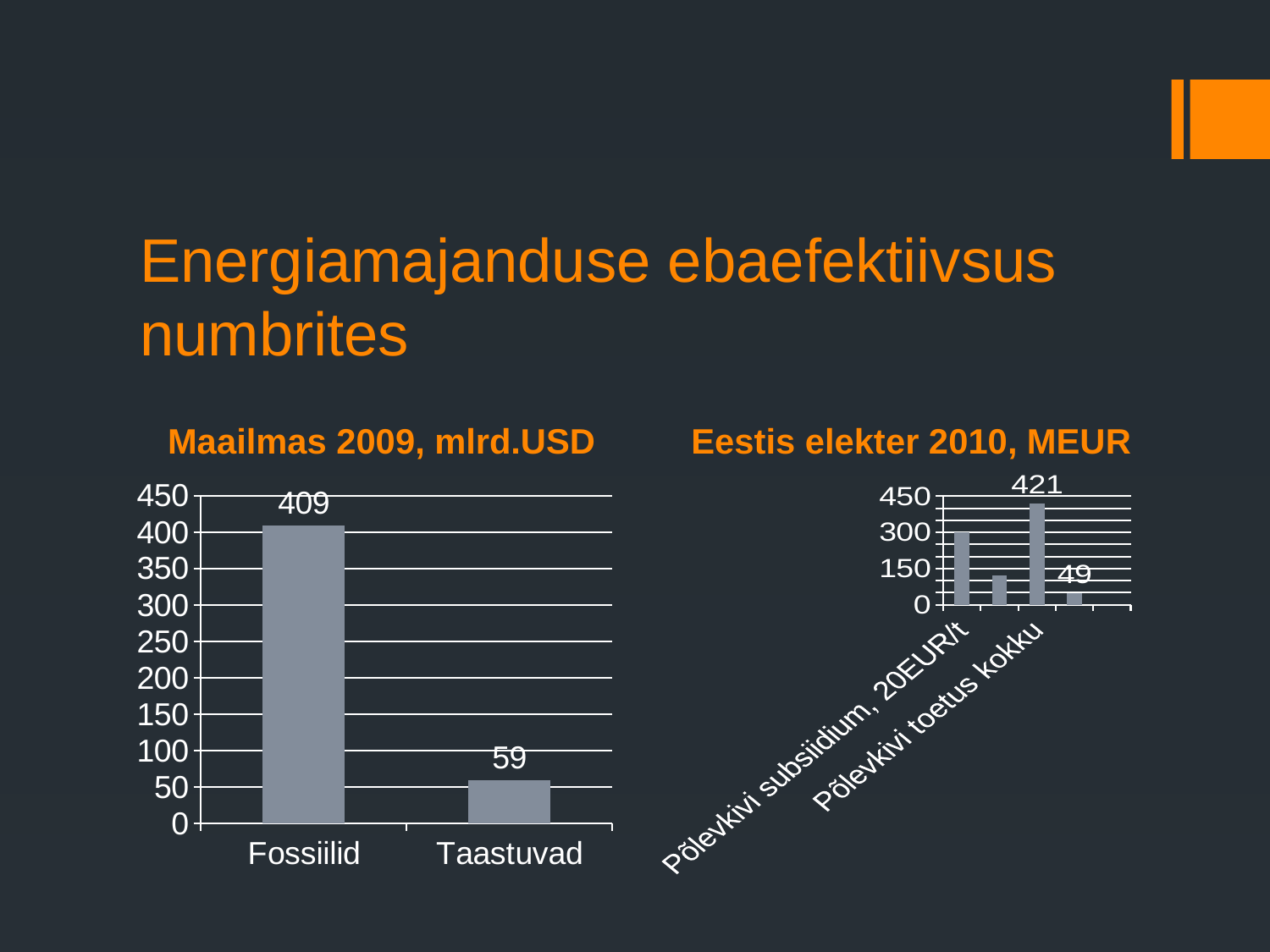
In the chart titled "Eestis elekter 2010, MEUR", is the value of the leftmost bar greater or less than 150? greater In the chart titled "Eestis elekter 2010, MEUR", how many bars are plotted? 4 In the chart titled "Eestis elekter 2010, MEUR", what is the value shown on the rightmost bar? 49 In the chart titled "Eestis elekter 2010, MEUR", what is the highest data label shown? 421 In the chart titled "Maailmas 2009, mlrd.USD", how many categories are shown? 2 What kind of chart is the one titled "Maailmas 2009, mlrd.USD"? Bar chart In the chart titled "Maailmas 2009, mlrd.USD", what is the difference between the values for Fossiilid and Taastuvad? 350 In the chart titled "Maailmas 2009, mlrd.USD", what is the value for Taastuvad? 59 How many charts are shown on the slide? 2 In the chart titled "Maailmas 2009, mlrd.USD", what is the value for Fossiilid? 409 In the chart titled "Maailmas 2009, mlrd.USD", which category has the highest value? Fossiilid In the chart titled "Maailmas 2009, mlrd.USD", which category has the lowest value? Taastuvad